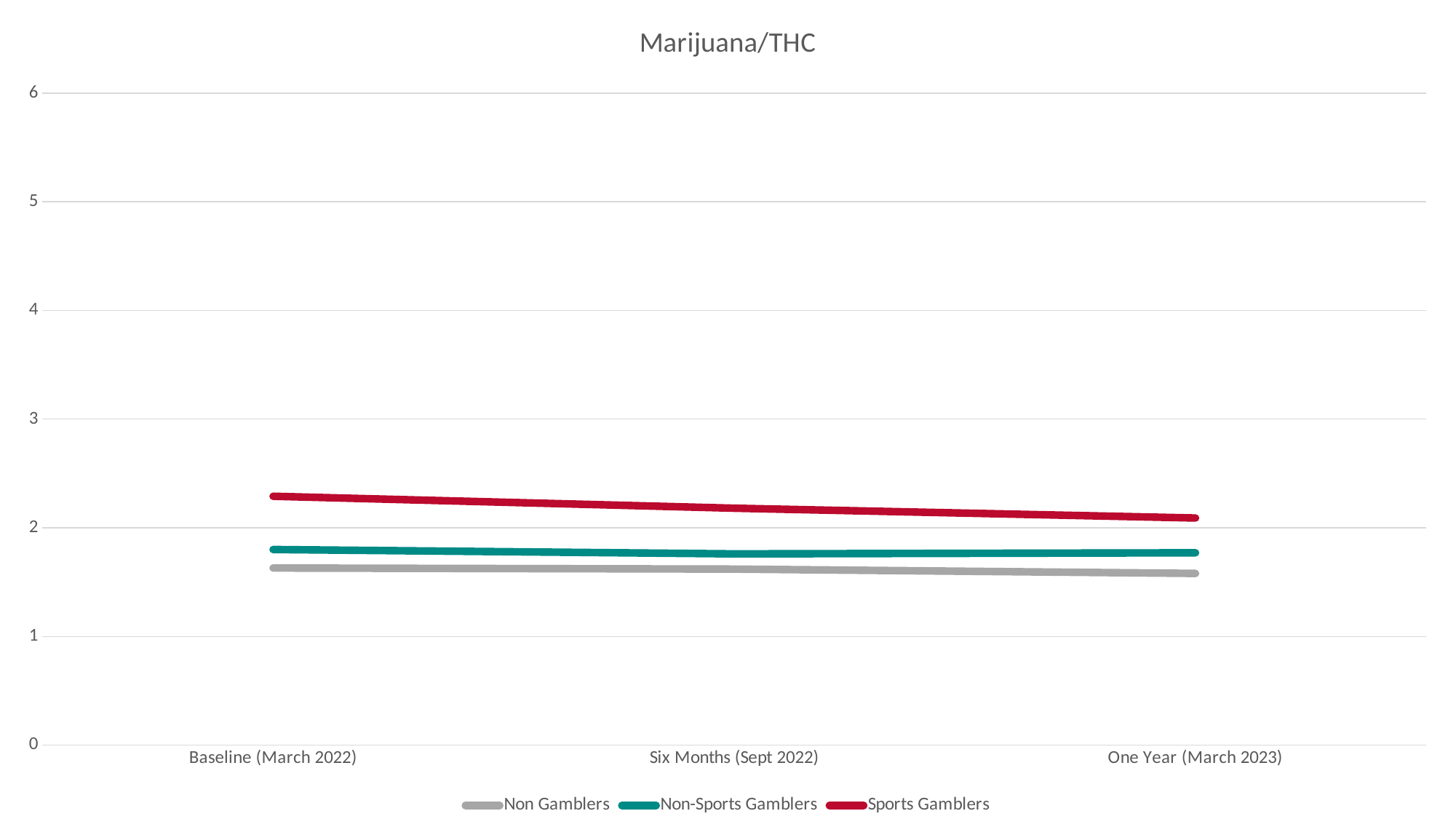
How many time points are plotted along the x axis? 3 At Baseline (March 2022), which is larger: the value for Sports Gamblers or the value for Non Gamblers? Sports Gamblers How many series does the legend list? 3 Does the Sports Gamblers line rise or fall from Baseline (March 2022) to One Year (March 2023)? fall Which series is drawn in red? Sports Gamblers Which series has the lowest value at One Year (March 2023)? Non Gamblers Is the value for Non Gamblers at One Year (March 2023) greater or less than 2? less Is the value for Non-Sports Gamblers at Six Months (Sept 2022) greater or less than 1? greater Which series has the highest value at Baseline (March 2022)? Sports Gamblers What kind of chart is shown on the slide? line chart Is the value for Sports Gamblers at Baseline (March 2022) greater or less than 2? greater What is the title of the chart? Marijuana/THC